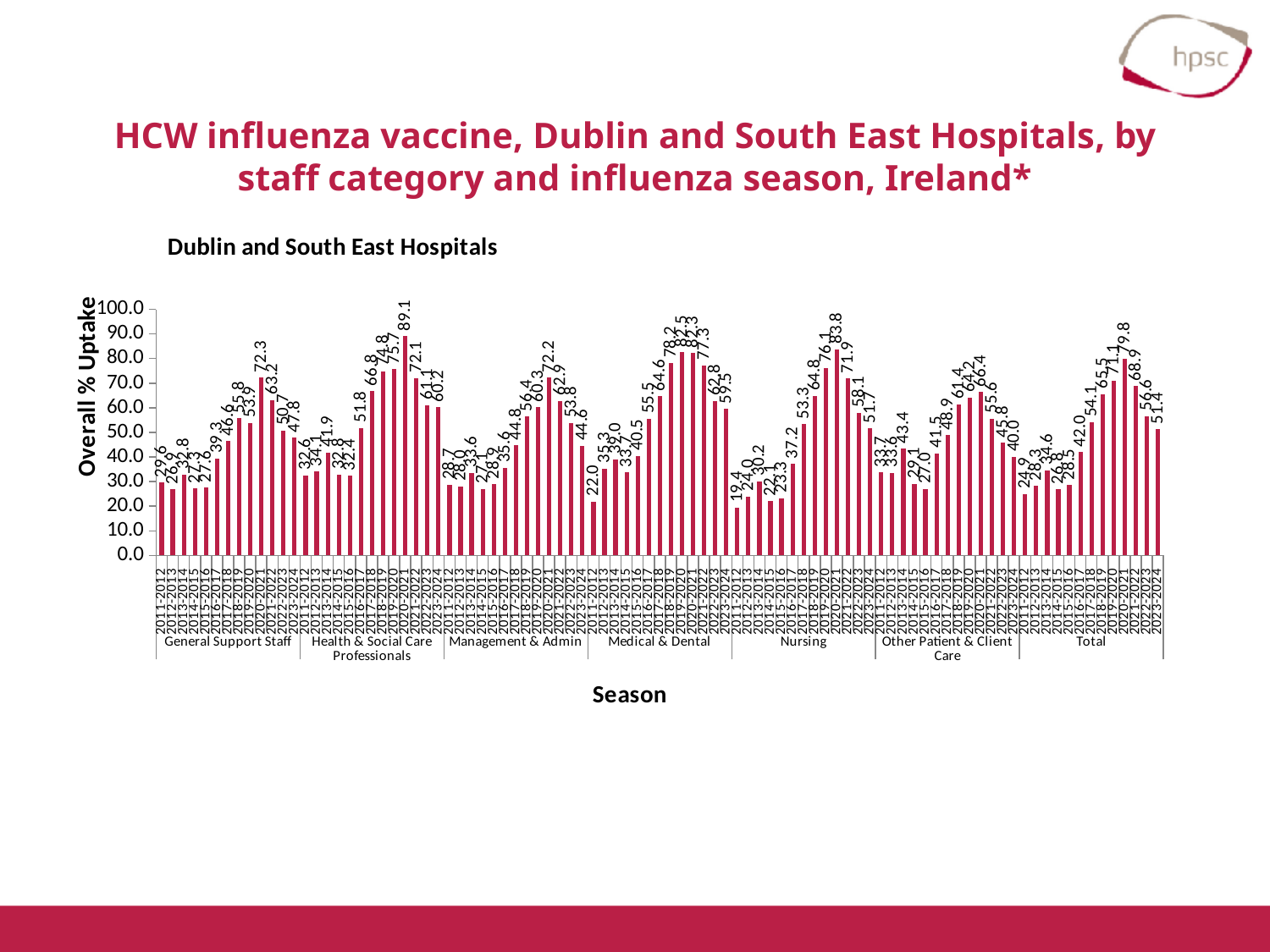
Which staff category and season has the lowest overall % uptake on the chart? Nursing, 2011-2012 (19.4) Which staff category and season has the highest overall % uptake on the chart? Health & Social Care Professionals, 2020-2021 (89.1) What type of chart is shown on the slide? Bar chart Within the Total group, does the uptake rise or fall from 2020-2021 to 2023-2024? fall In the 2020-2021 season, which is larger: the uptake for Nursing or for the Total group? Nursing How many seasons are plotted within each staff category group? 13 How many staff category groups are shown along the x axis? 7 Is the value for Medical & Dental in 2011-2012 greater or less than 30? less What is the overall % uptake for Health & Social Care Professionals in the 2020-2021 season? 89.1 What is the difference between the Total group's uptake in 2020-2021 and in 2011-2012? 54.9 What is the overall % uptake for the Total group in the 2020-2021 season? 79.8 What is the overall % uptake for Nursing in the 2020-2021 season? 83.8